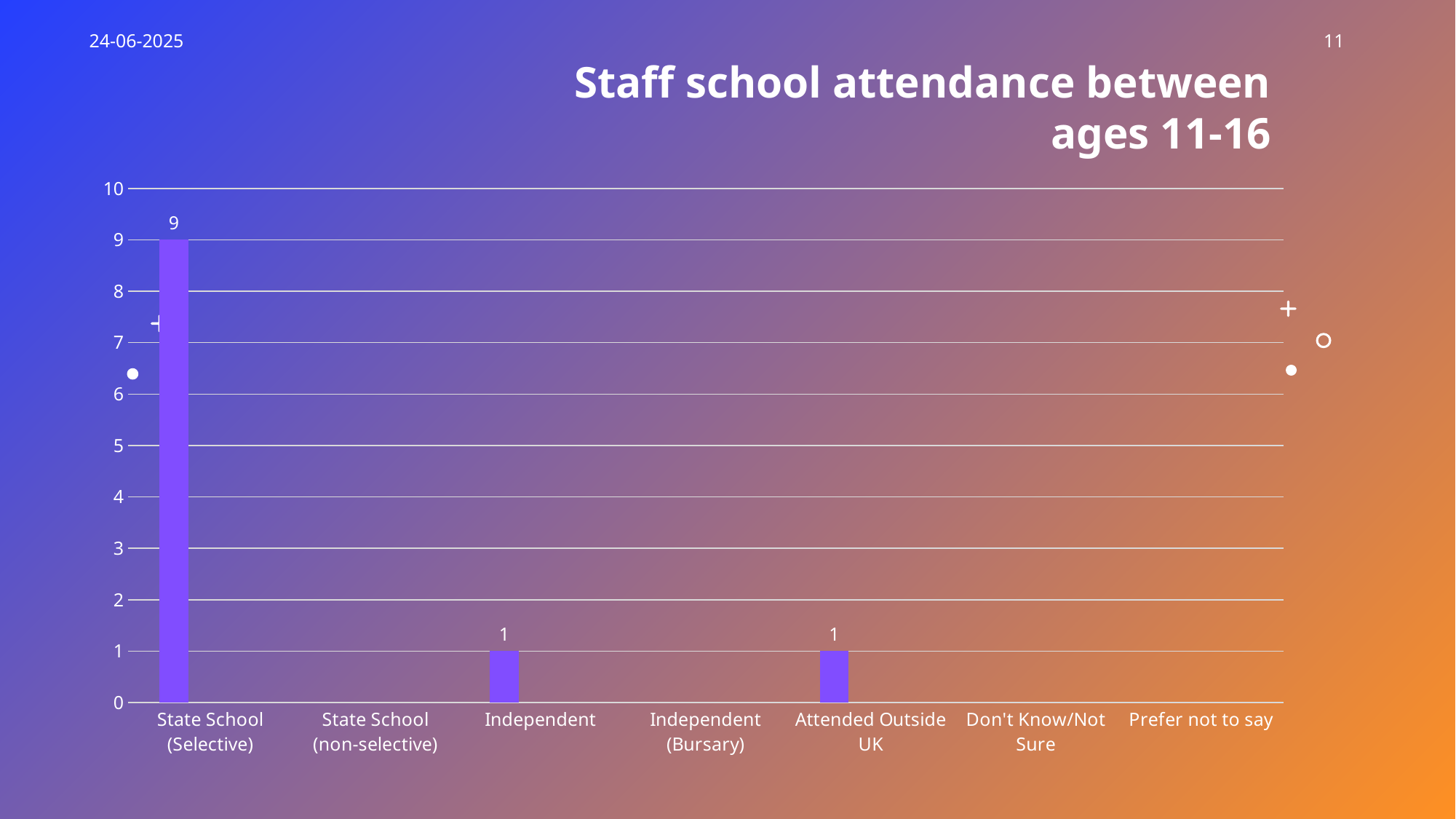
What is the value for State School (Selective)? 9 Which is larger, the value for State School (Selective) or the value for Attended Outside UK? State School (Selective) How many categories are shown on the x axis? 7 What is the title of the chart? Staff school attendance between ages 11-16 Is the value for State School (Selective) greater or less than 5? greater Which category has the highest value? State School (Selective) What is the difference between the values for State School (Selective) and Independent? 8 Is the value for Independent greater or less than 5? less What is the highest value shown on the y axis? 10 What is the value for Attended Outside UK? 1 What is the value for Independent? 1 What kind of chart is shown on the slide? bar chart